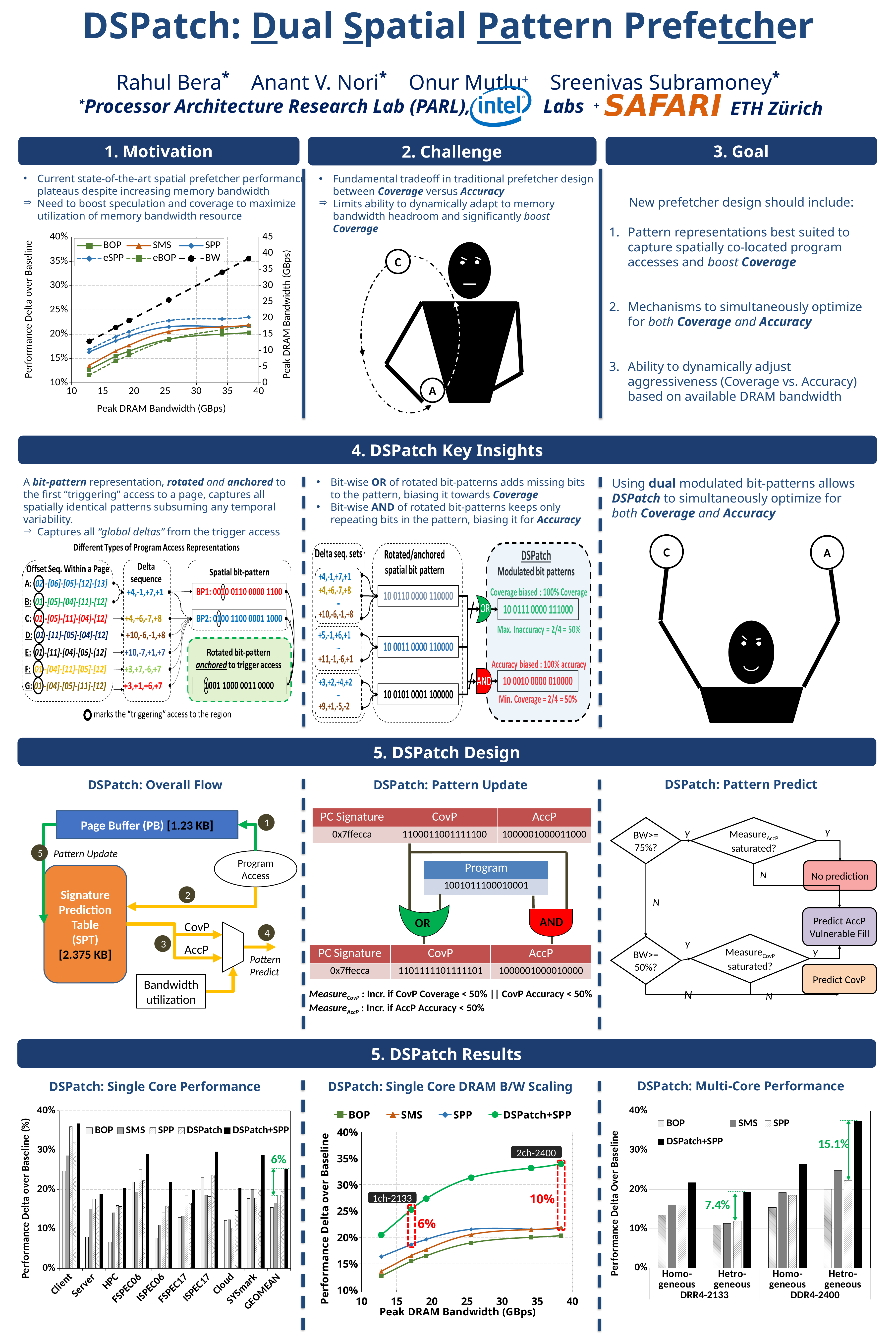
What kind of chart is the DSPatch: Single Core Performance chart? bar chart What kind of chart is the DSPatch: Single Core DRAM B/W Scaling chart? line chart In the DSPatch: Multi-Core Performance chart, which series has the highest bar for Heterogeneous DDR4-2400? DSPatch+SPP In the DSPatch: Single Core DRAM B/W Scaling chart, does the DSPatch+SPP line rise or fall as Peak DRAM Bandwidth increases? rises In the DSPatch: Single Core Performance chart, how many workload categories are shown on the x axis? 10 In the Motivation section chart, how many series does the legend list? 6 In the DSPatch: Single Core Performance chart, how many series does the legend list? 5 In the DSPatch: Single Core DRAM B/W Scaling chart, how many series does the legend list? 4 In the DSPatch: Single Core DRAM B/W Scaling chart, is the DSPatch+SPP value at the 2ch-2400 point greater or less than 30%? greater In the DSPatch: Multi-Core Performance chart, what improvement percentage is annotated for Heterogeneous DDR4-2400? 15.1% In the DSPatch: Single Core Performance chart, is the DSPatch+SPP value for GEOMEAN greater or less than 20%? greater In the DSPatch: Single Core Performance chart, which category has the highest DSPatch+SPP bar? Client